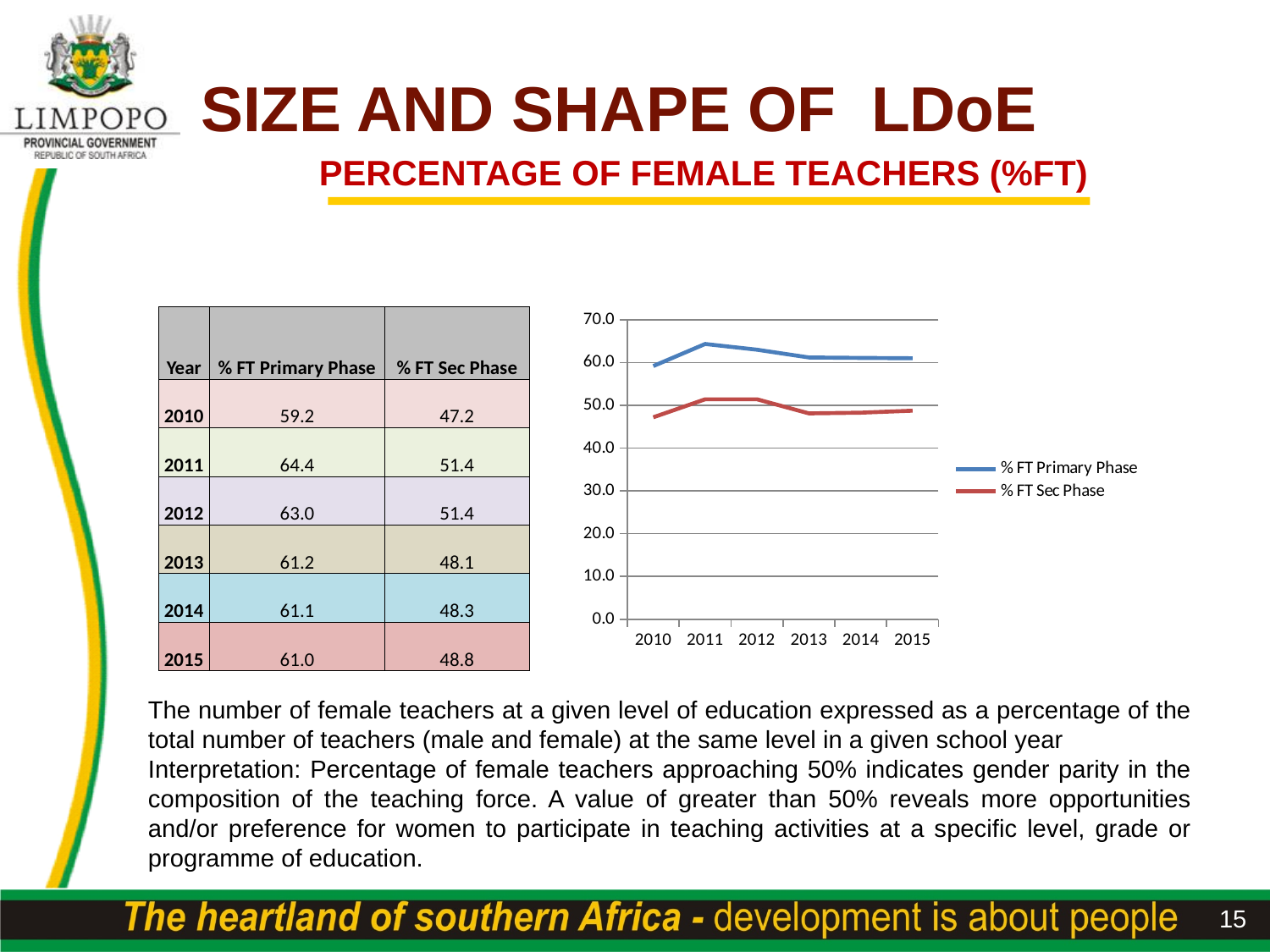
Is the % FT Primary Phase value for 2010 greater or less than 50.0? greater In which year is the % FT Primary Phase highest? 2011 What is the % FT Sec Phase value for 2010? 47.2 What is the difference between the % FT Primary Phase and % FT Sec Phase values in 2013? 13.1 How many years are plotted along the x axis of the chart? 6 What kind of chart is shown on the slide? line chart Which series has the larger value in 2014, % FT Primary Phase or % FT Sec Phase? % FT Primary Phase How many series does the chart legend list? 2 Does the % FT Primary Phase line rise or fall from 2011 to 2015? fall What is the % FT Sec Phase value for 2015? 48.8 What is the % FT Primary Phase value for 2011? 64.4 In which year is the % FT Sec Phase lowest? 2010